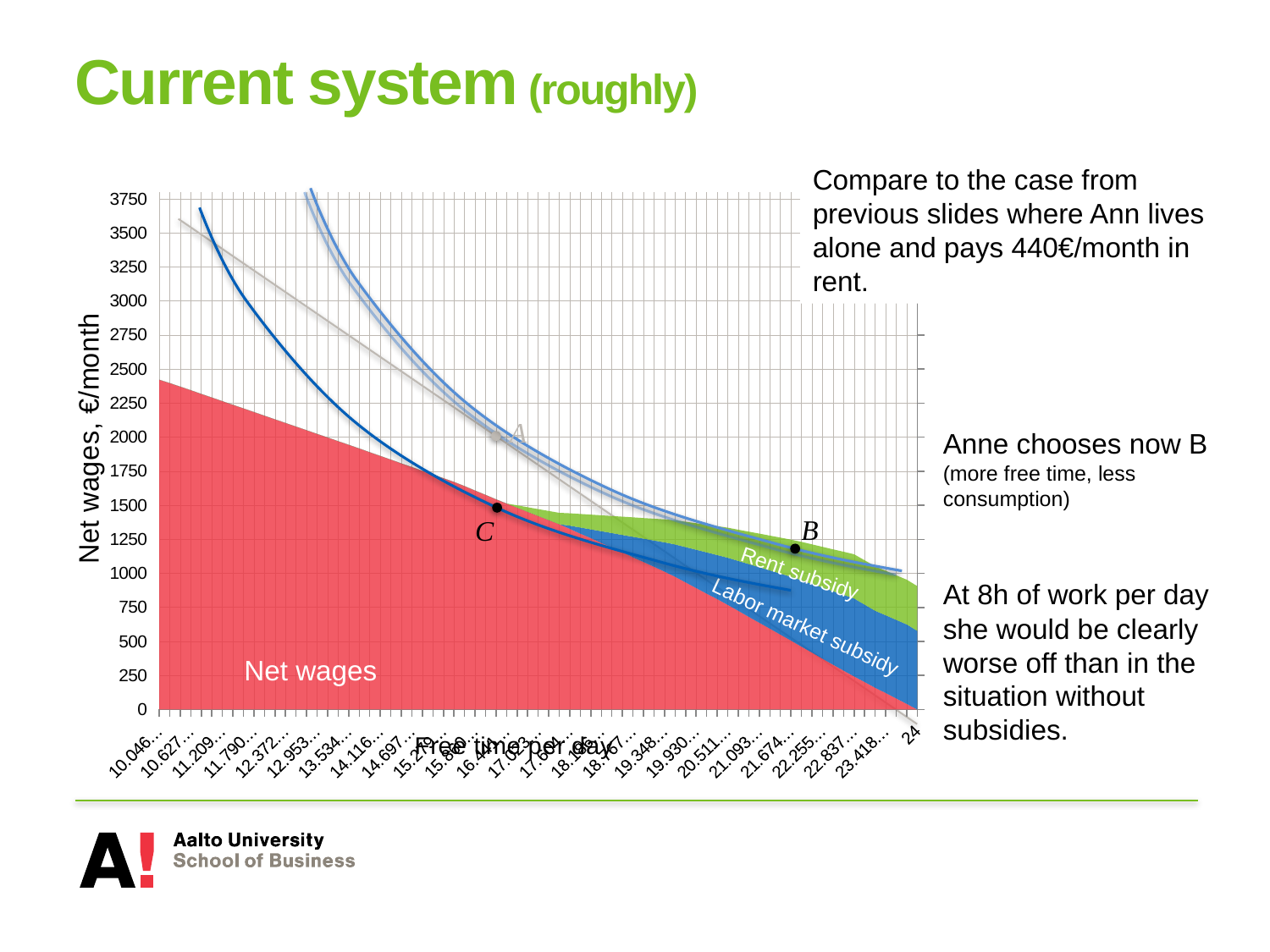
What kind of chart is shown on the slide? Area chart Which of the labelled points, B or C, lies at a higher net wage level? C Which shaded area is coloured red in the chart? Net wages What is the label of the horizontal axis of the chart? Free time per day Is the net wage level at point B greater or less than 1500 €/month? less Which shaded area is coloured green in the chart? Rent subsidy How many shaded areas (series) are labelled in the chart? 3 What is the label of the vertical axis of the chart? Net wages, €/month What is the highest value shown on the vertical axis of the chart? 3750 Does the Net wages area rise or fall as free time per day increases? Fall Is the net wage at the leftmost point of the chart (free time 10.046) greater or less than 2250 €/month? greater What is the last value shown on the horizontal axis of the chart? 24